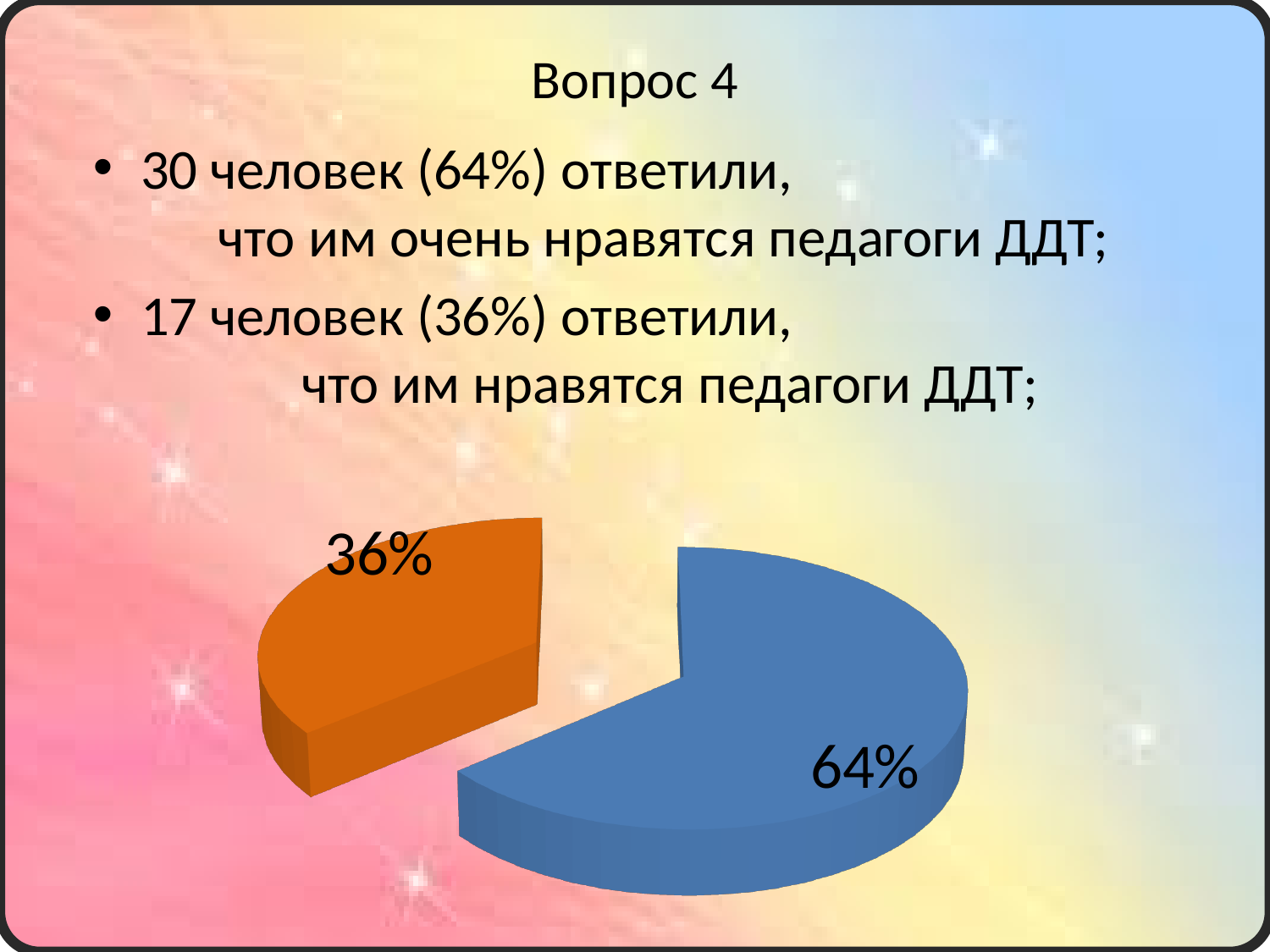
What colour is the slice labelled 36%? orange What is the title of the slide containing the pie chart? Вопрос 4 What share of the pie corresponds to the 30 people who answered that they very much like the DDT teachers? 64% Which slice of the pie chart is the smallest? the orange slice (36%) What kind of chart is shown on the slide? pie chart Which slice of the pie chart is the largest? the blue slice (64%) Is the blue slice or the orange slice of the pie chart larger? the blue slice Is the share of the orange slice greater or less than 50%? less How many slices does the pie chart have? 2 What percentage is shown on the blue slice of the pie chart? 64% What percentage is shown on the orange slice of the pie chart? 36% What is the difference in percentage points between the two slices of the pie chart? 28